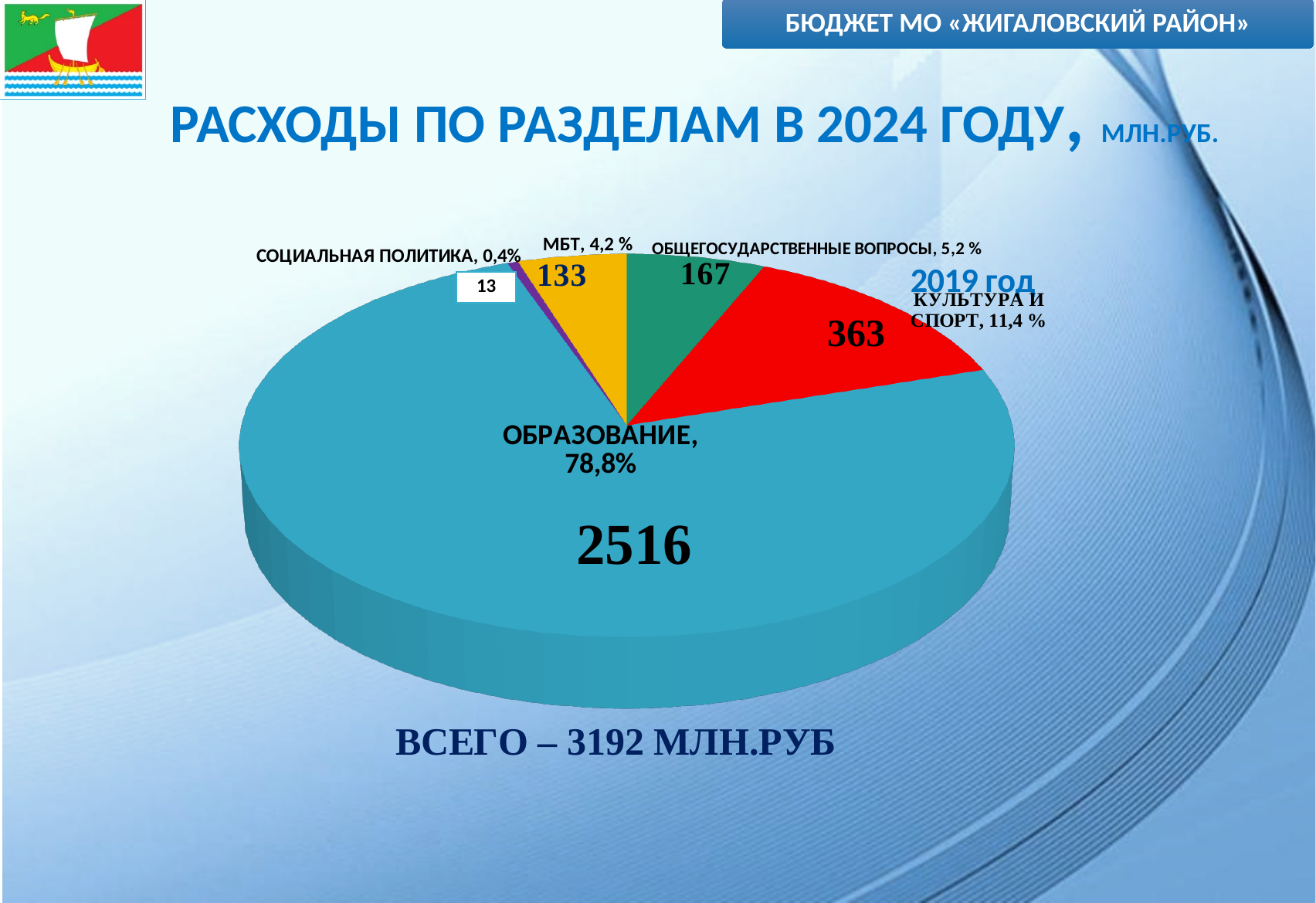
What is the value for ОБЩЕГОСУДАРСТВЕННЫЕ ВОПРОСЫ? 167 How many sections are shown in the pie chart? 5 What is the value for КУЛЬТУРА И СПОРТ? 363 What is the difference between the values for КУЛЬТУРА И СПОРТ and ОБЩЕГОСУДАРСТВЕННЫЕ ВОПРОСЫ? 196 Which is larger, the value for МБТ or the value for ОБЩЕГОСУДАРСТВЕННЫЕ ВОПРОСЫ? ОБЩЕГОСУДАРСТВЕННЫЕ ВОПРОСЫ What is the value for ОБРАЗОВАНИЕ? 2516 Which section has the smallest share of the pie? СОЦИАЛЬНАЯ ПОЛИТИКА Which section has the largest share of the pie? ОБРАЗОВАНИЕ What is the value for МБТ? 133 What is the value for СОЦИАЛЬНАЯ ПОЛИТИКА? 13 What kind of chart is shown on the slide? pie chart What share of the pie does КУЛЬТУРА И СПОРТ represent? 11,4 %